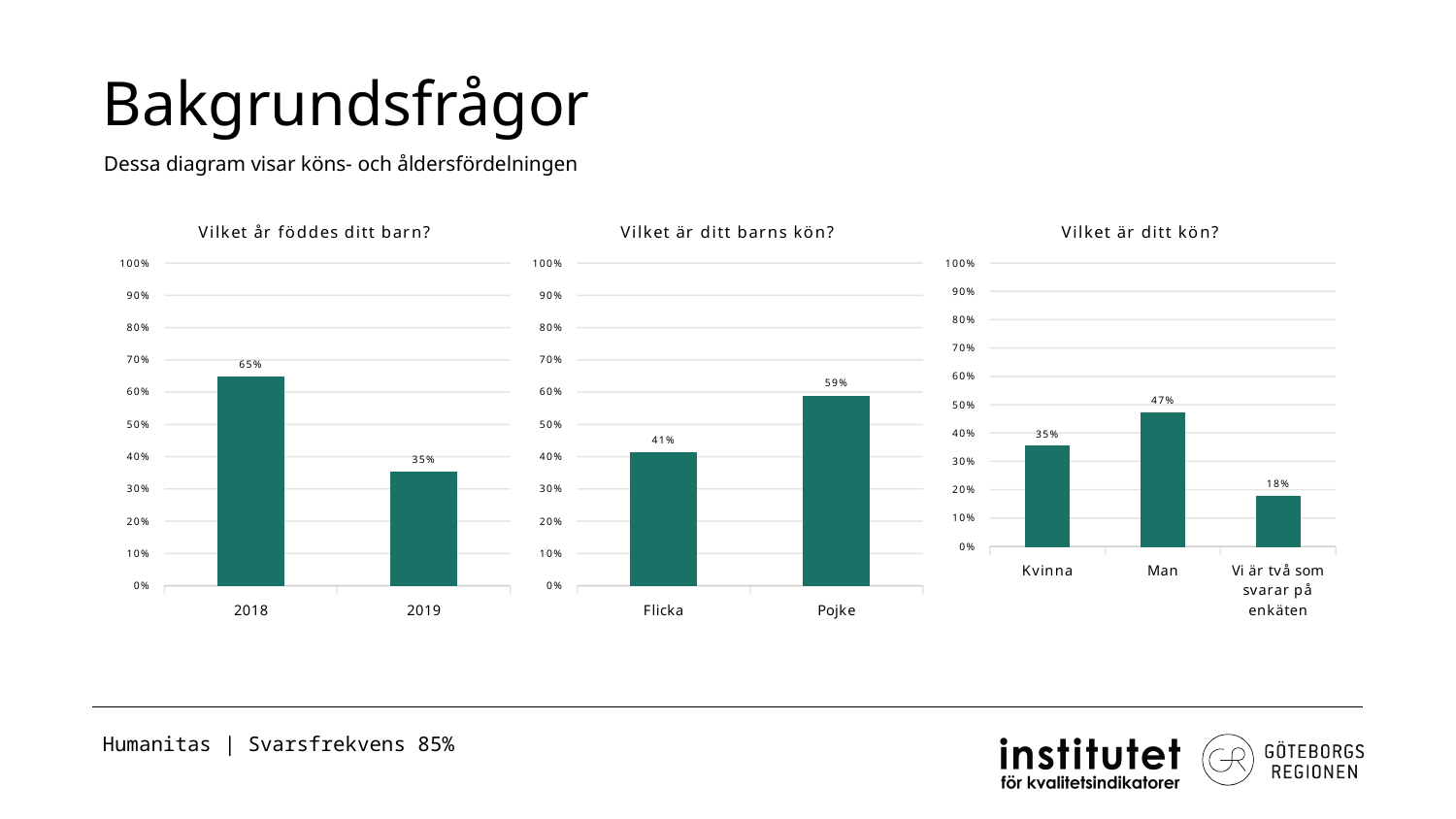
In the chart 'Vilket är ditt barns kön?', which category has the highest value? Pojke In the chart 'Vilket är ditt kön?', what is the value for Man? 47% In the chart 'Vilket är ditt kön?', how many categories are shown? 3 In the chart 'Vilket är ditt kön?', which category has the lowest value? Vi är två som svarar på enkäten How many charts are shown on the slide? 3 In the chart 'Vilket år föddes ditt barn?', what is the difference between the values for 2018 and 2019? 30% In the chart 'Vilket år föddes ditt barn?', what is the value for 2019? 35% In the chart 'Vilket är ditt barns kön?', what is the value for Flicka? 41% What kind of chart is 'Vilket är ditt barns kön?'? Bar chart In the chart 'Vilket år föddes ditt barn?', what is the value for 2018? 65% In the chart 'Vilket är ditt kön?', which is larger, Kvinna or Man? Man In the chart 'Vilket är ditt barns kön?', what is the difference between Pojke and Flicka? 18%